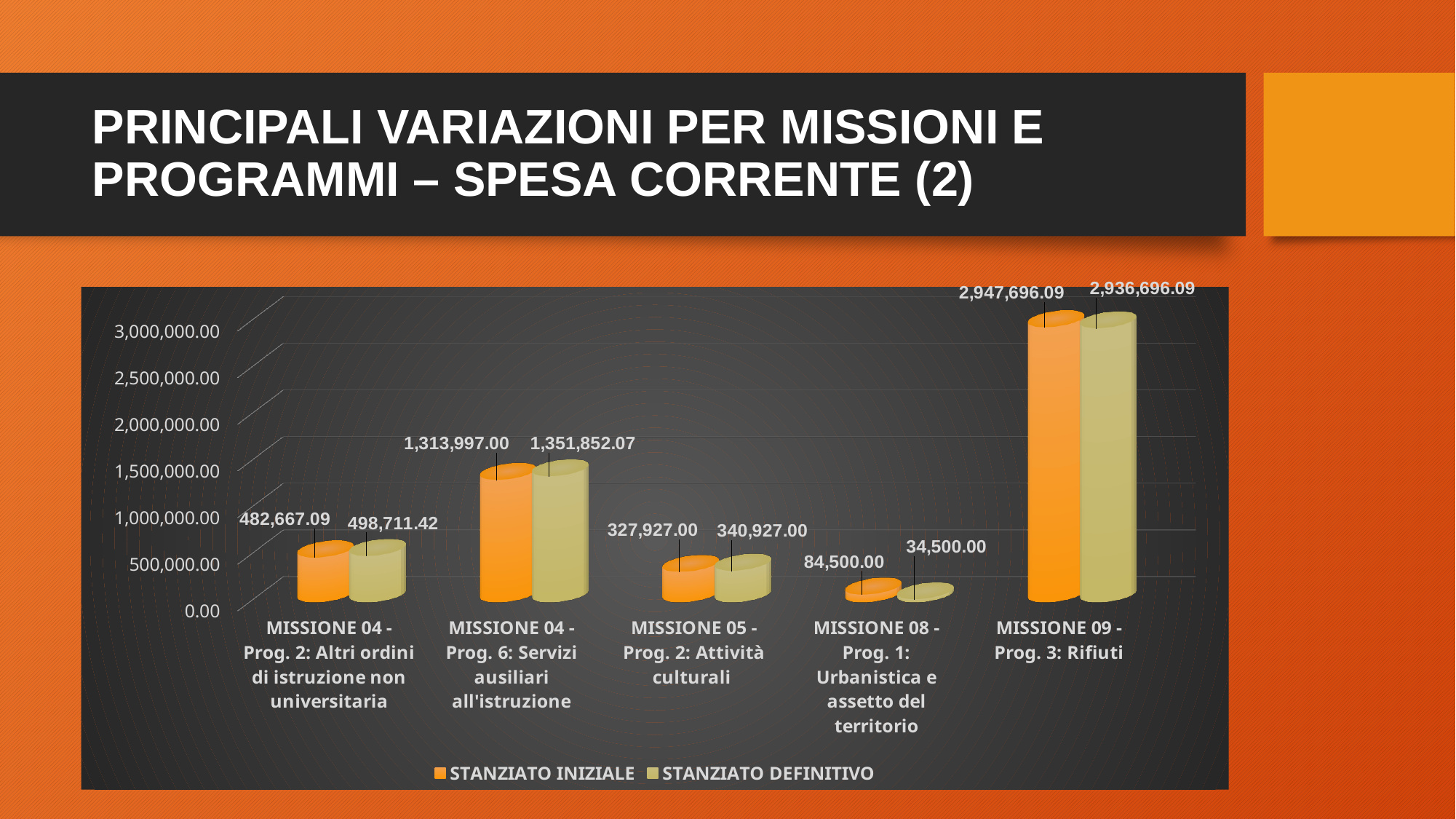
What is the STANZIATO DEFINITIVO value for MISSIONE 08 - Prog. 1: Urbanistica e assetto del territorio? 34,500.00 What kind of chart is shown on the slide? bar chart What is the STANZIATO INIZIALE value for MISSIONE 09 - Prog. 3: Rifiuti? 2,947,696.09 How many series does the chart legend list? 2 What is the difference between STANZIATO INIZIALE and STANZIATO DEFINITIVO for MISSIONE 08 - Prog. 1: Urbanistica e assetto del territorio? 50,000.00 Which category has the lowest STANZIATO DEFINITIVO value? MISSIONE 08 - Prog. 1: Urbanistica e assetto del territorio Which category has the highest STANZIATO INIZIALE value? MISSIONE 09 - Prog. 3: Rifiuti Is the STANZIATO INIZIALE value for MISSIONE 04 - Prog. 6: Servizi ausiliari all'istruzione greater or less than 1,000,000.00? greater What is the STANZIATO DEFINITIVO value for MISSIONE 04 - Prog. 6: Servizi ausiliari all'istruzione? 1,351,852.07 How many categories are shown on the x axis of the chart? 5 What is the difference between STANZIATO DEFINITIVO and STANZIATO INIZIALE for MISSIONE 05 - Prog. 2: Attività culturali? 13,000.00 For MISSIONE 04 - Prog. 2: Altri ordini di istruzione non universitaria, which is larger: STANZIATO INIZIALE or STANZIATO DEFINITIVO? STANZIATO DEFINITIVO